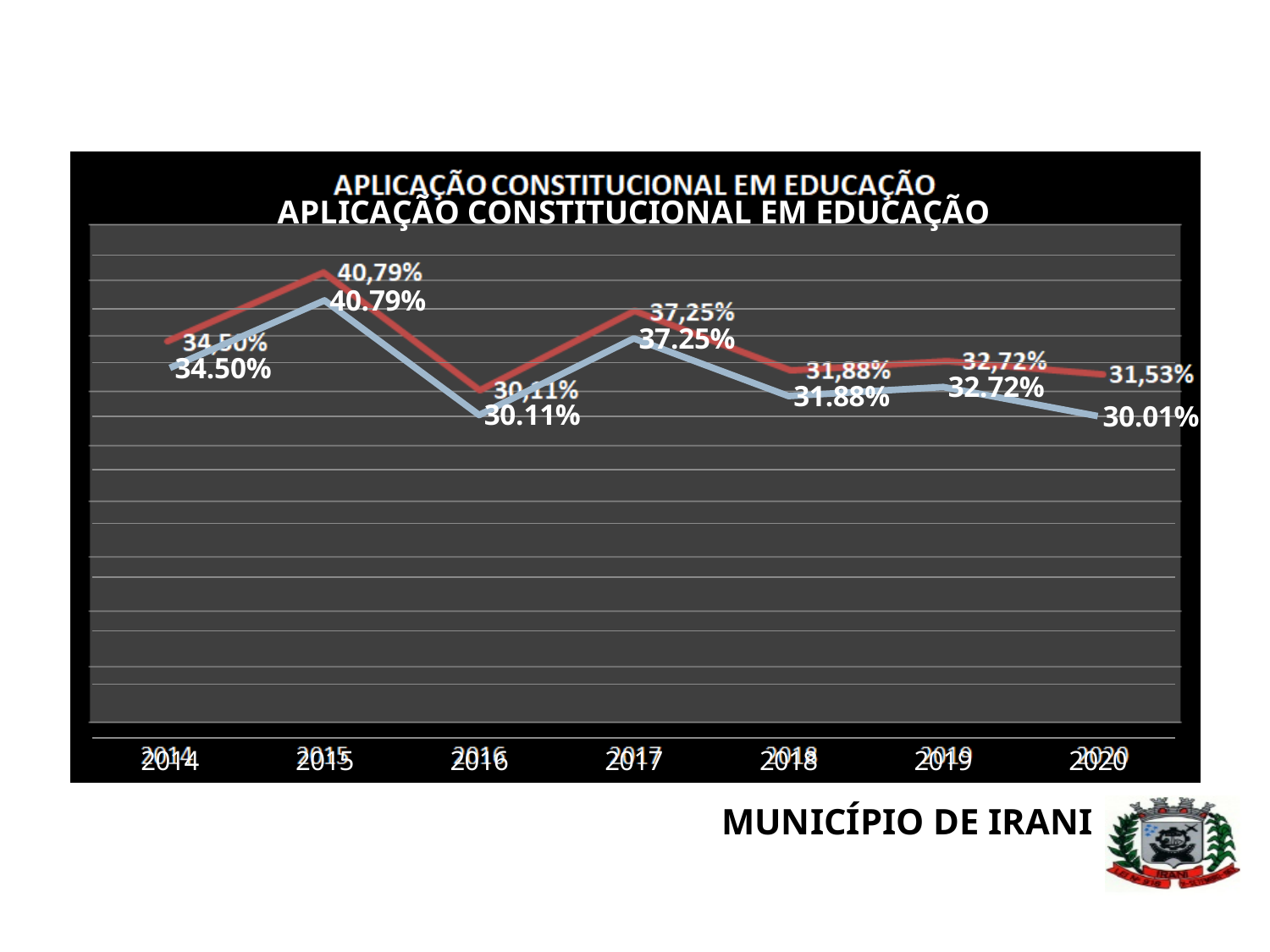
What is the value of the blue line for 2020? 30.01% Which is larger, the value for 2014 or the value for 2019? 2014 What is the value shown for 2015 on the chart? 40.79% Does the value rise or fall from 2015 to 2016? fall What is the value shown for 2018 on the chart? 31.88% Which year has the highest value on the chart? 2015 What is the value shown for 2017 on the chart? 37.25% What is the title of the chart? APLICAÇÃO CONSTITUCIONAL EM EDUCAÇÃO How many years are shown on the x axis of the chart? 7 Which year has the lowest value on the blue line? 2020 What is the difference between the values for 2015 and 2016 on the blue line? 10.68 percentage points What kind of chart is shown on the slide? line chart